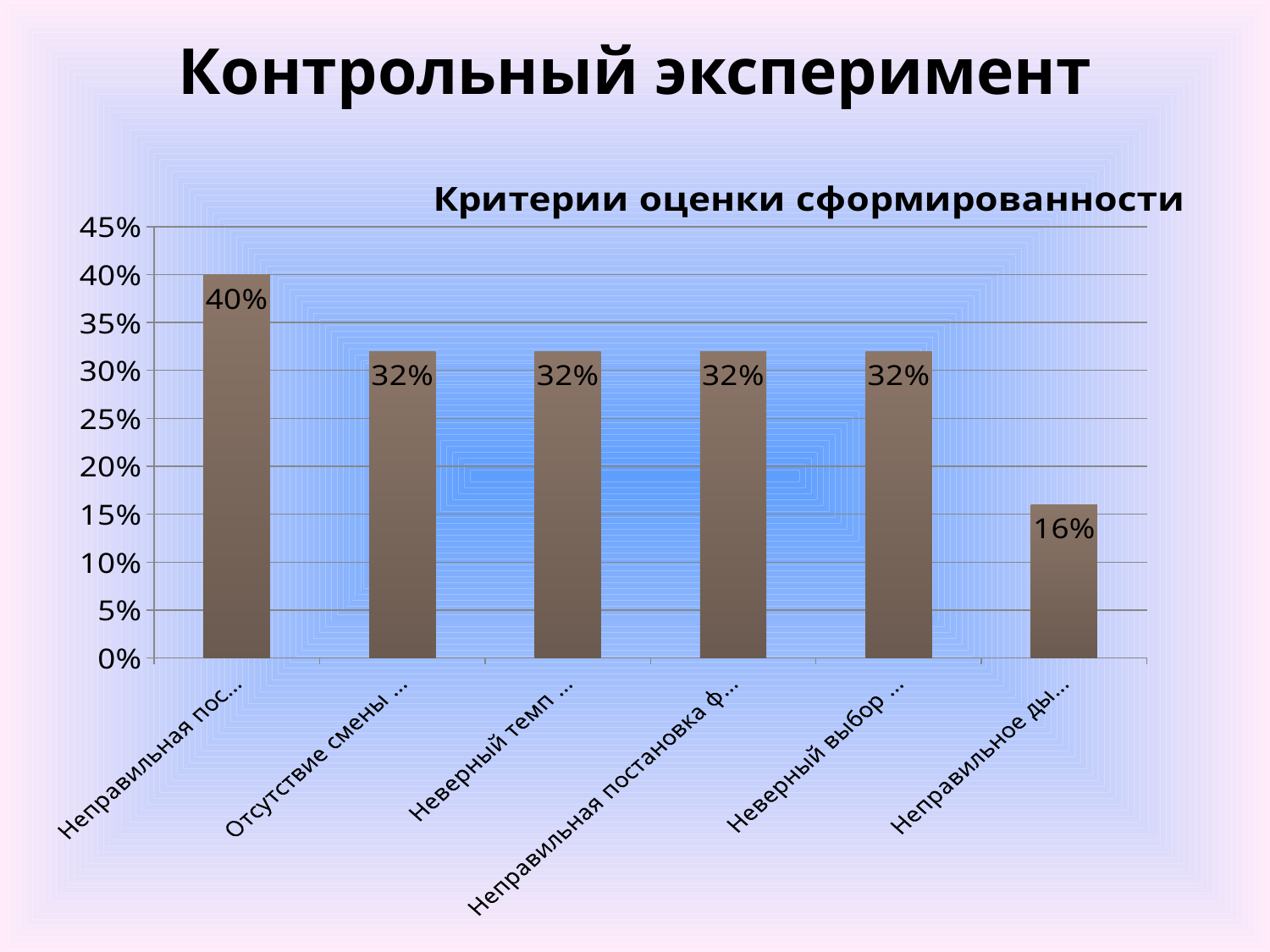
What is the difference between the first bar (40%) and the bar labelled "Отсутствие смены ..." (32%)? 8% What is the title of the chart? Критерии оценки сформированности Which category has the lowest value? Неправильное ды... (the last bar) What is the value of the first bar ("Неправильная пос...")? 40% What kind of chart is shown on the slide? bar chart What is the difference between the highest bar (40%) and the lowest bar (16%)? 24% Which is larger: the value for "Неверный выбор ..." or the value for "Неправильное ды..."? Неверный выбор ... How many bars have a value of 32%? 4 What is the value of the bar labelled "Неверный темп ..."? 32% What is the value of the last bar ("Неправильное ды...")? 16% How many bars (categories) does the chart show? 6 Which category has the highest value? Неправильная пос... (the first bar)